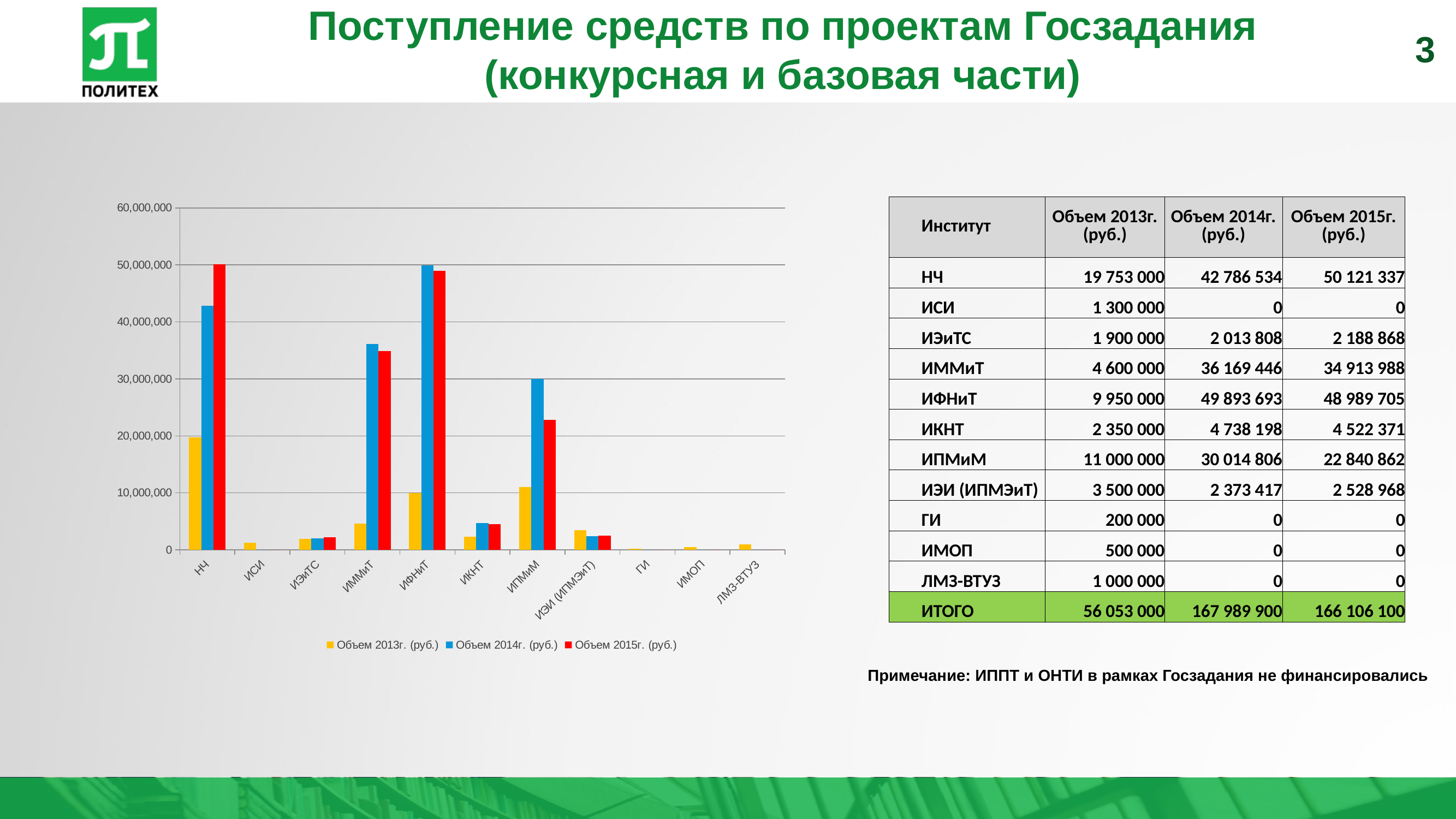
What is the value of Объем 2014г. (руб.) for ИММиТ? 36 169 446 What is the value of Объем 2013г. (руб.) for ИПМиМ? 11 000 000 Which institute has the highest value for Объем 2015г. (руб.)? НЧ Which colour represents the series Объем 2015г. (руб.) in the chart? red How many series does the chart legend list? 3 Is the value of Объем 2015г. (руб.) for ИПМиМ greater or less than 30,000,000? less What is the difference between Объем 2015г. (руб.) and Объем 2013г. (руб.) for НЧ? 30 368 337 How many institutes (categories) are shown on the x axis of the chart? 11 Which is larger for ИФНиТ: Объем 2014г. (руб.) or Объем 2015г. (руб.)? Объем 2014г. (руб.) Is the value of Объем 2014г. (руб.) for НЧ greater or less than 40,000,000? greater Which institute has the highest value for Объем 2014г. (руб.)? ИФНиТ What kind of chart is shown on the slide? bar chart